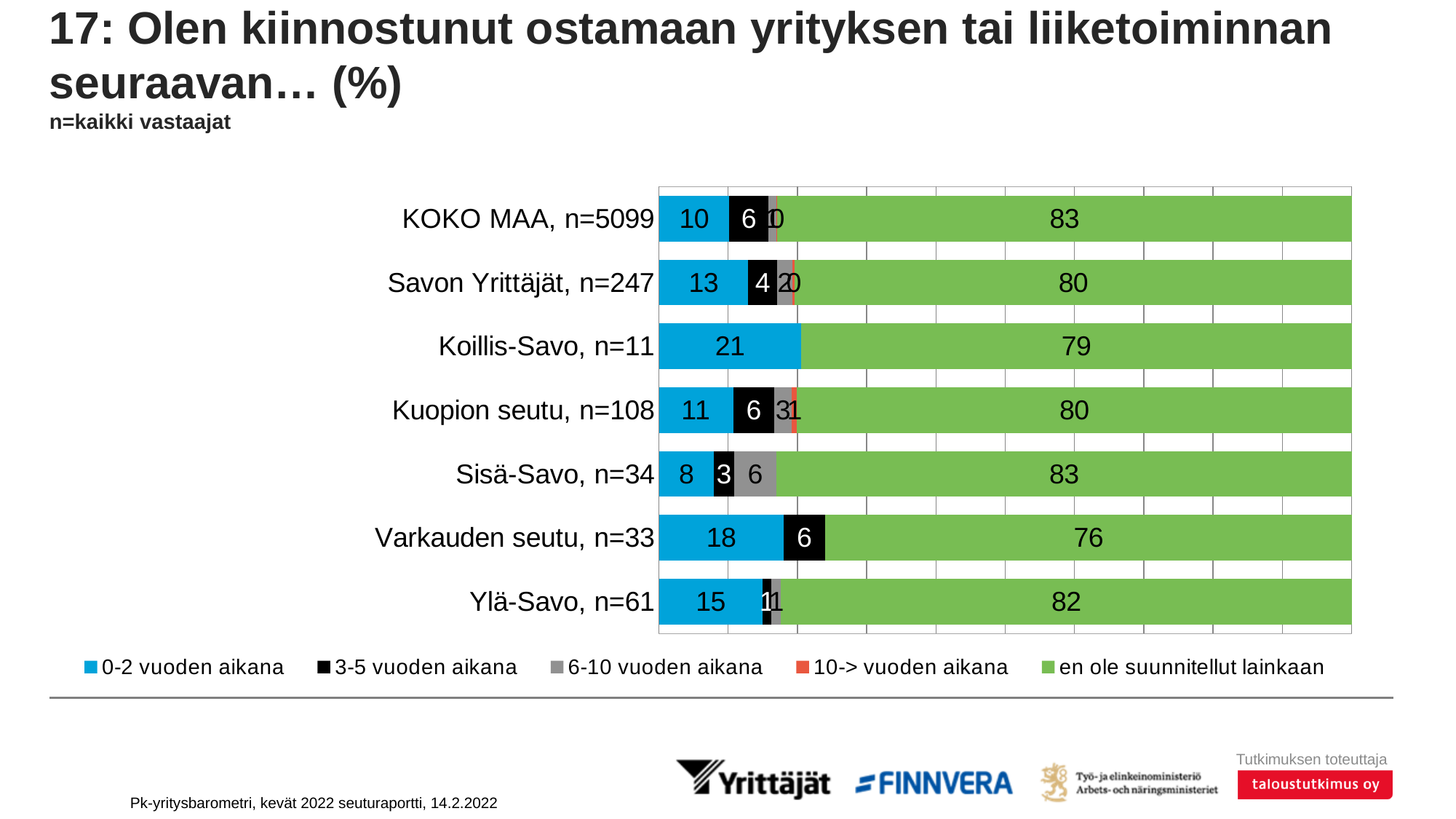
Which legend entry is shown in green? en ole suunnitellut lainkaan Which category has the highest value for "0-2 vuoden aikana"? Koillis-Savo, n=11 What is the value of "0-2 vuoden aikana" for Koillis-Savo, n=11? 21 What is the value of "6-10 vuoden aikana" for Sisä-Savo, n=34? 6 What is the difference between the "0-2 vuoden aikana" values for Varkauden seutu, n=33 and Sisä-Savo, n=34? 10 What is the value of "3-5 vuoden aikana" for Varkauden seutu, n=33? 6 What type of chart is shown on the slide? stacked bar chart Which is larger: the "0-2 vuoden aikana" value for Savon Yrittäjät, n=247 or for Ylä-Savo, n=61? Ylä-Savo, n=61 What is the value of "en ole suunnitellut lainkaan" for KOKO MAA, n=5099? 83 How many series does the legend list? 5 Which category has the lowest value for "en ole suunnitellut lainkaan"? Varkauden seutu, n=33 How many categories (rows) are plotted in the chart? 7